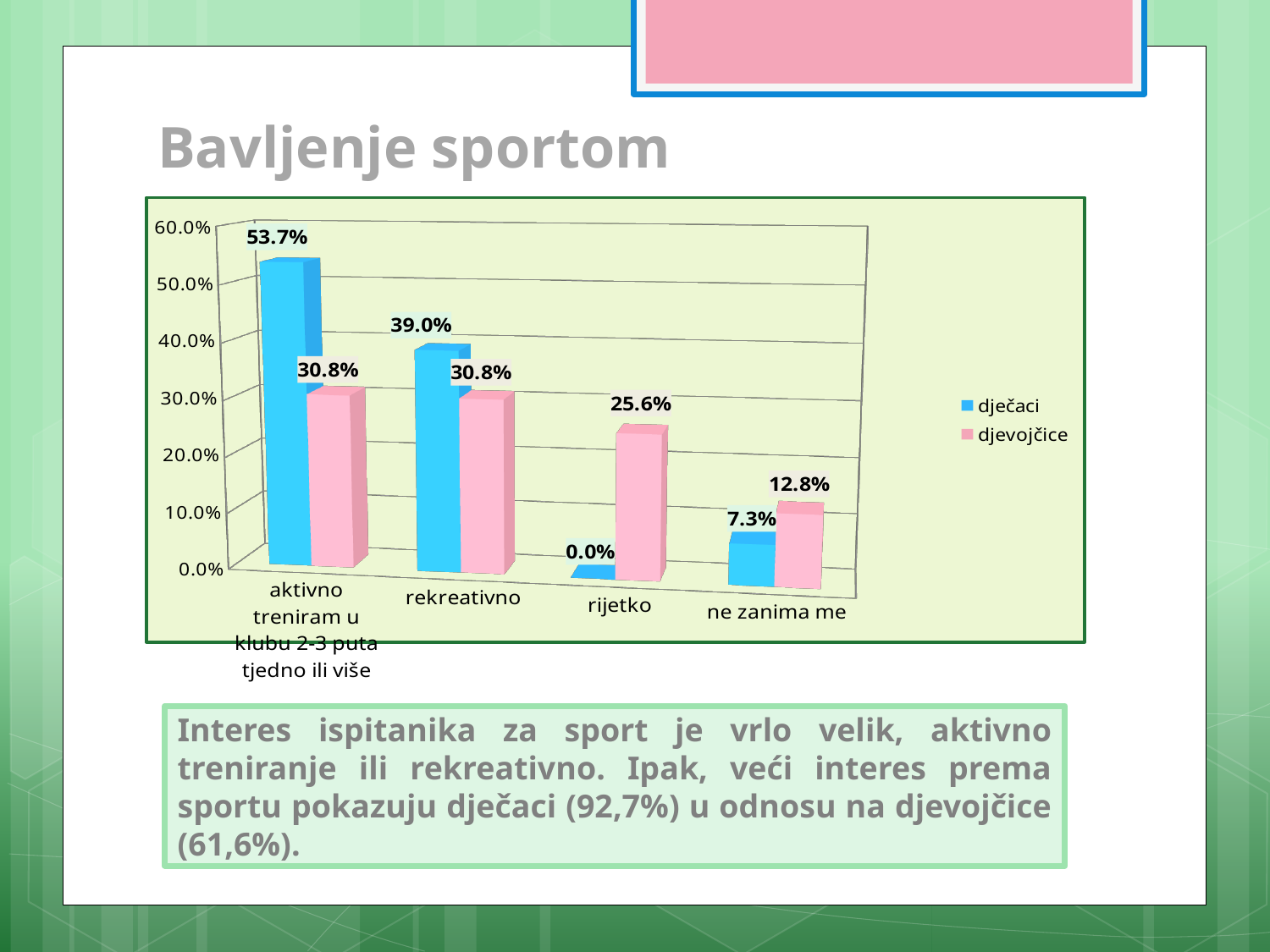
In the rekreativno category, which series has the larger value, dječaci or djevojčice? dječaci What is the difference between the dječaci and djevojčice values in the aktivno treniram u klubu 2-3 puta tjedno ili više category? 22.9% What kind of chart is shown on the slide? bar chart What is the value for dječaci in the rekreativno category? 39.0% How many categories are shown on the x axis? 4 Which category has the highest value for dječaci? aktivno treniram u klubu 2-3 puta tjedno ili više How many series does the legend list? 2 Which category has the lowest value for dječaci? rijetko What is the value for djevojčice in the rijetko category? 25.6% Which category has the lowest value for djevojčice? ne zanima me What is the value for djevojčice in the ne zanima me category? 12.8% What is the value for dječaci in the ne zanima me category? 7.3%